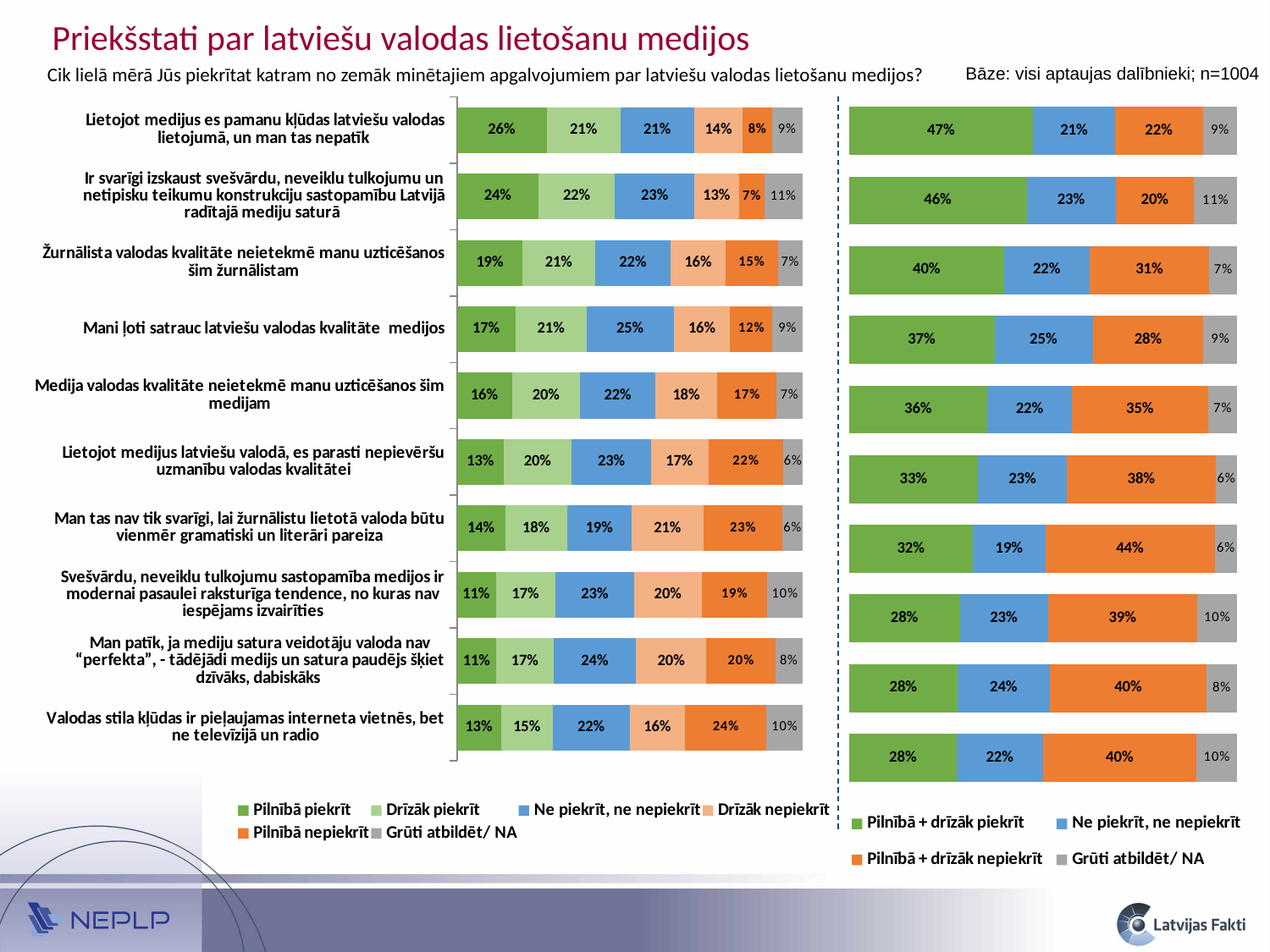
In the right chart, which has the larger "Pilnībā + drīzāk piekrīt" value: "Žurnālista valodas kvalitāte neietekmē manu uzticēšanos šim žurnālistam" or "Mani ļoti satrauc latviešu valodas kvalitāte medijos"? Žurnālista valodas kvalitāte neietekmē manu uzticēšanos šim žurnālistam In the left chart, what percentage chose "Pilnībā piekrīt" for the statement "Lietojot medijus es pamanu kļūdas latviešu valodas lietojumā, un man tas nepatīk"? 26% How many statements (categories) are shown in the left chart? 10 In the right chart, what is the "Ne piekrīt, ne nepiekrīt" value for the statement "Man patīk, ja mediju satura veidotāju valoda nav “perfekta”, - tādējādi medijs un satura paudējs šķiet dzīvāks, dabiskāks"? 24% In the left chart, which statement has the lowest "Pilnībā nepiekrīt" value? Ir svarīgi izskaust svešvārdu, neveiklu tulkojumu un netipisku teikumu konstrukciju sastopamību Latvijā radītajā mediju saturā In the right chart, what is the difference in "Pilnībā + drīzāk piekrīt" between "Lietojot medijus es pamanu kļūdas latviešu valodas lietojumā, un man tas nepatīk" (47%) and "Valodas stila kļūdas ir pieļaujamas interneta vietnēs, bet ne televīzijā un radio" (28%)? 19 percentage points In the right chart, which statement has the highest "Pilnībā + drīzāk nepiekrīt" value? Man tas nav tik svarīgi, lai žurnālistu lietotā valoda būtu vienmēr gramatiski un literāri pareiza In the left chart, what is the "Grūti atbildēt/ NA" value for the statement "Ir svarīgi izskaust svešvārdu, neveiklu tulkojumu un netipisku teikumu konstrukciju sastopamību Latvijā radītajā mediju saturā"? 11% In the right chart, what is the "Pilnībā + drīzāk piekrīt" value for the statement "Lietojot medijus es pamanu kļūdas latviešu valodas lietojumā, un man tas nepatīk"? 47% How many series does the legend of the right chart list? 4 What kind of chart is the right chart? Stacked bar chart How many series does the legend of the left chart list? 6